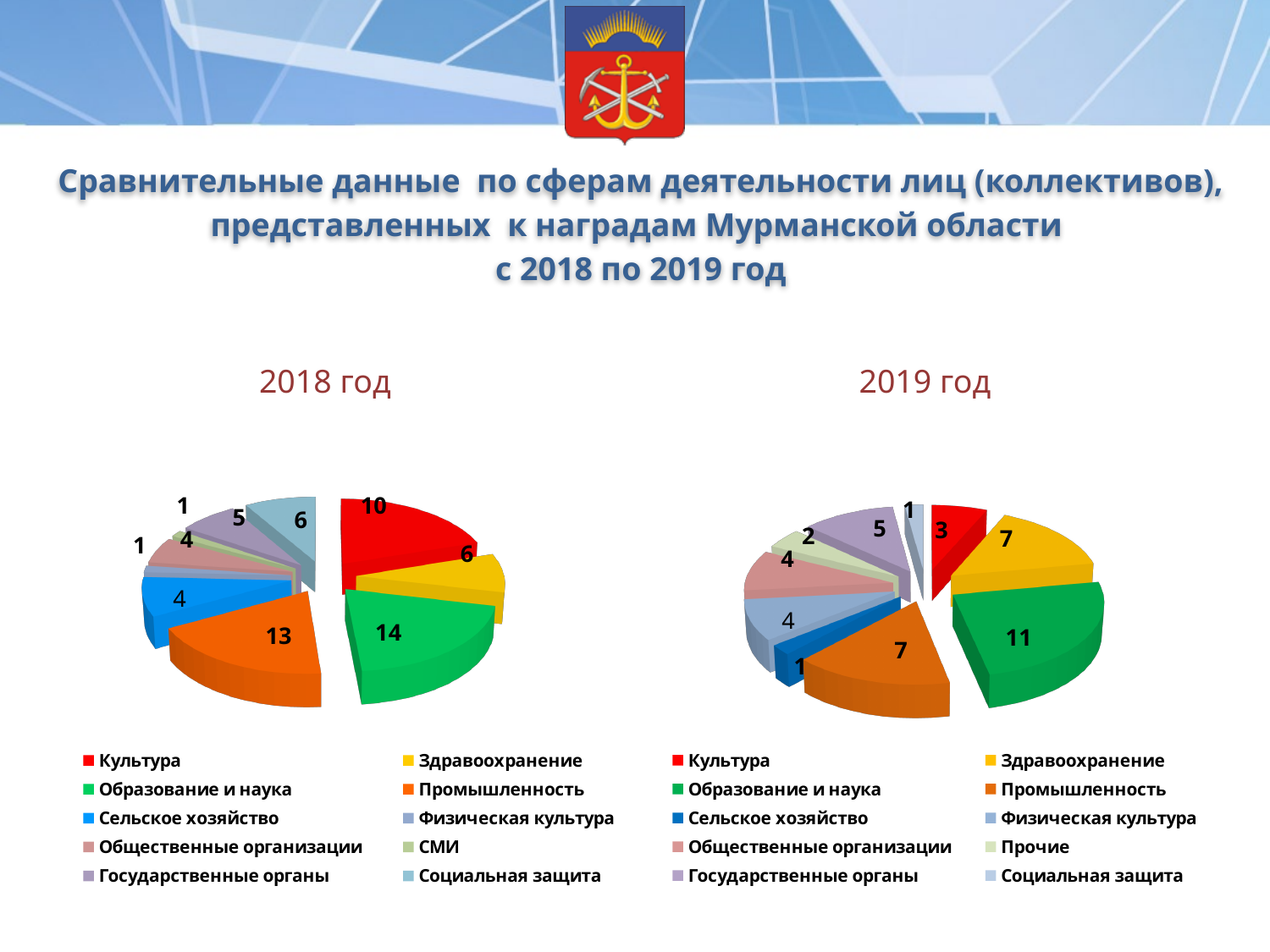
In the 2019 год chart, what is the value for Культура? 3 In the 2019 год chart, what is the value for Здравоохранение? 7 In the 2018 год chart, what is the value for Культура? 10 How many categories does the legend of the 2019 год chart list? 10 In the 2018 год chart, what is the value for Образование и наука? 14 In the 2018 год chart, which category has the largest slice? Образование и наука In the 2018 год chart, what is the value for Промышленность? 13 What type of chart is used for the 2018 год data? Pie chart In the 2019 год chart, which category has the largest slice? Образование и наука In the 2019 год chart, what is the value for Образование и наука? 11 What is the difference between the value for Культура in the 2018 год chart and in the 2019 год chart? 7 In the 2018 год chart, which is larger: Промышленность or Здравоохранение? Промышленность